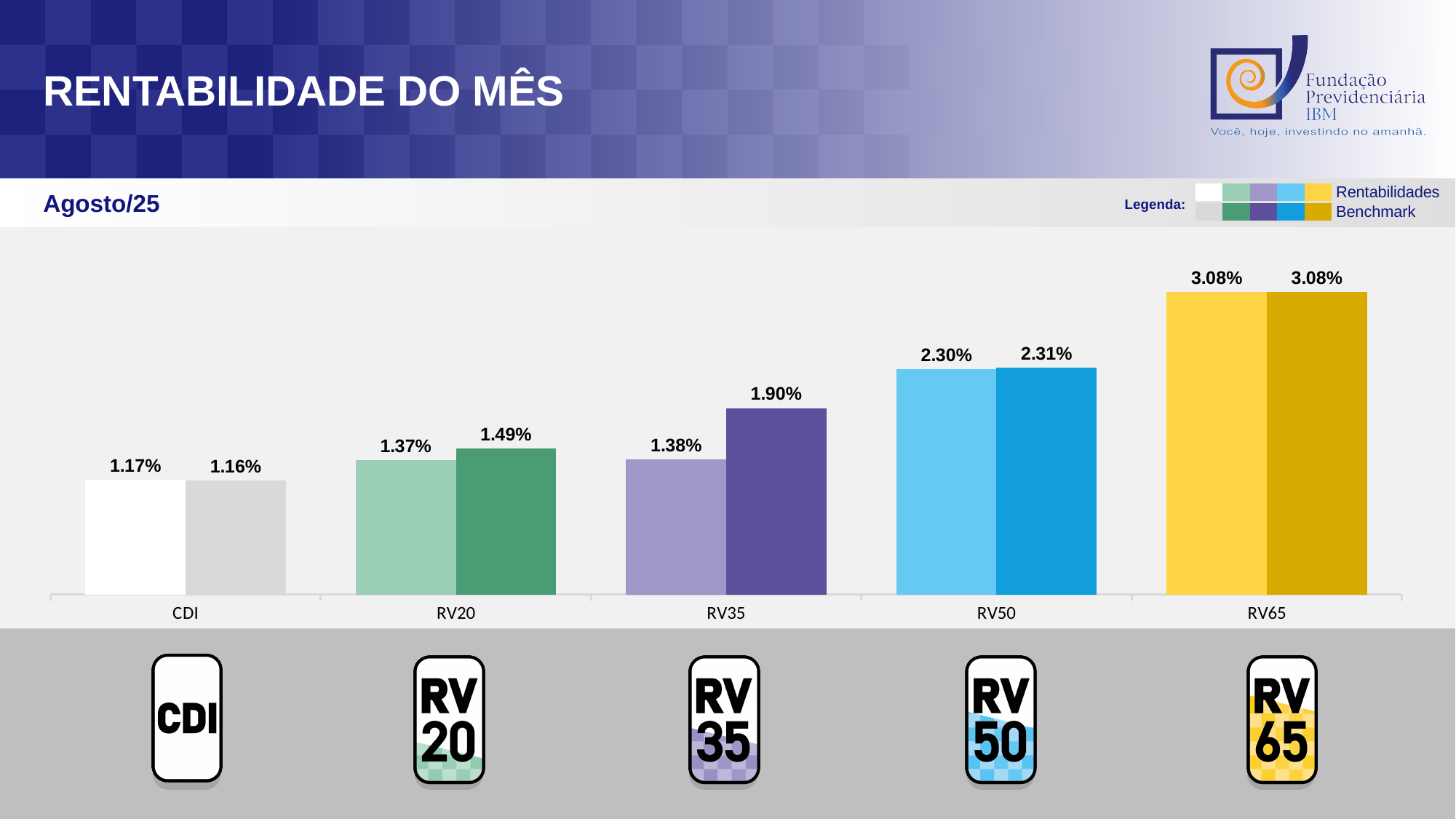
Which is larger for RV20: the Rentabilidades value or the Benchmark value? Benchmark Which category has the lowest Benchmark value? CDI What is the Rentabilidades value for RV35? 1.38% Do the Rentabilidades values rise or fall from CDI to RV65 along the x axis? Rise Which category has the highest Rentabilidades value? RV65 What is the difference between the Benchmark and Rentabilidades values for RV35? 0.52% How many categories are shown on the x axis of the chart? 5 How many series does the legend list? 2 What is the Benchmark value for RV20? 1.49% What is the Rentabilidades value for CDI? 1.17% What is the Benchmark value for RV50? 2.31% What kind of chart is shown on the slide? Bar chart